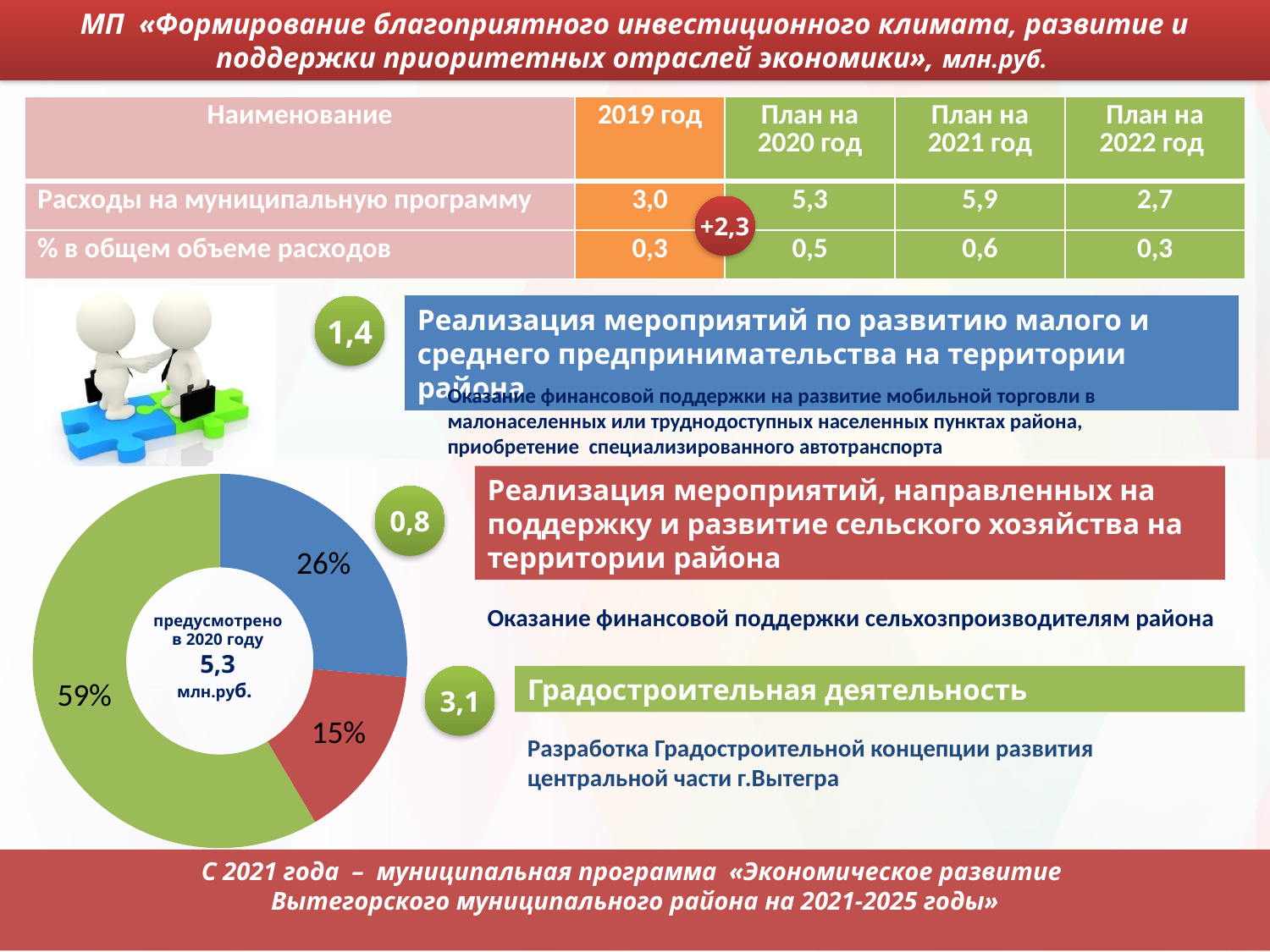
What percentage is shown on the green slice of the doughnut chart? 59% What is the difference in percentage points between the green slice and the blue slice of the doughnut chart? 33 percentage points What total amount is written in the centre of the doughnut chart? 5,3 млн.руб. Which slice of the doughnut chart is the smallest? The red slice (15%) Which is larger in the doughnut chart, the blue slice or the red slice? The blue slice What is the difference in percentage points between the blue slice and the red slice of the doughnut chart? 11 percentage points What percentage is shown on the red slice of the doughnut chart? 15% According to the text in the centre of the doughnut chart, for which year is the amount planned? 2020 What percentage is shown on the blue slice of the doughnut chart? 26% How many slices does the doughnut chart have? 3 Which slice of the doughnut chart is the largest? The green slice (59%) What kind of chart is shown on the left of the slide? Doughnut (pie) chart